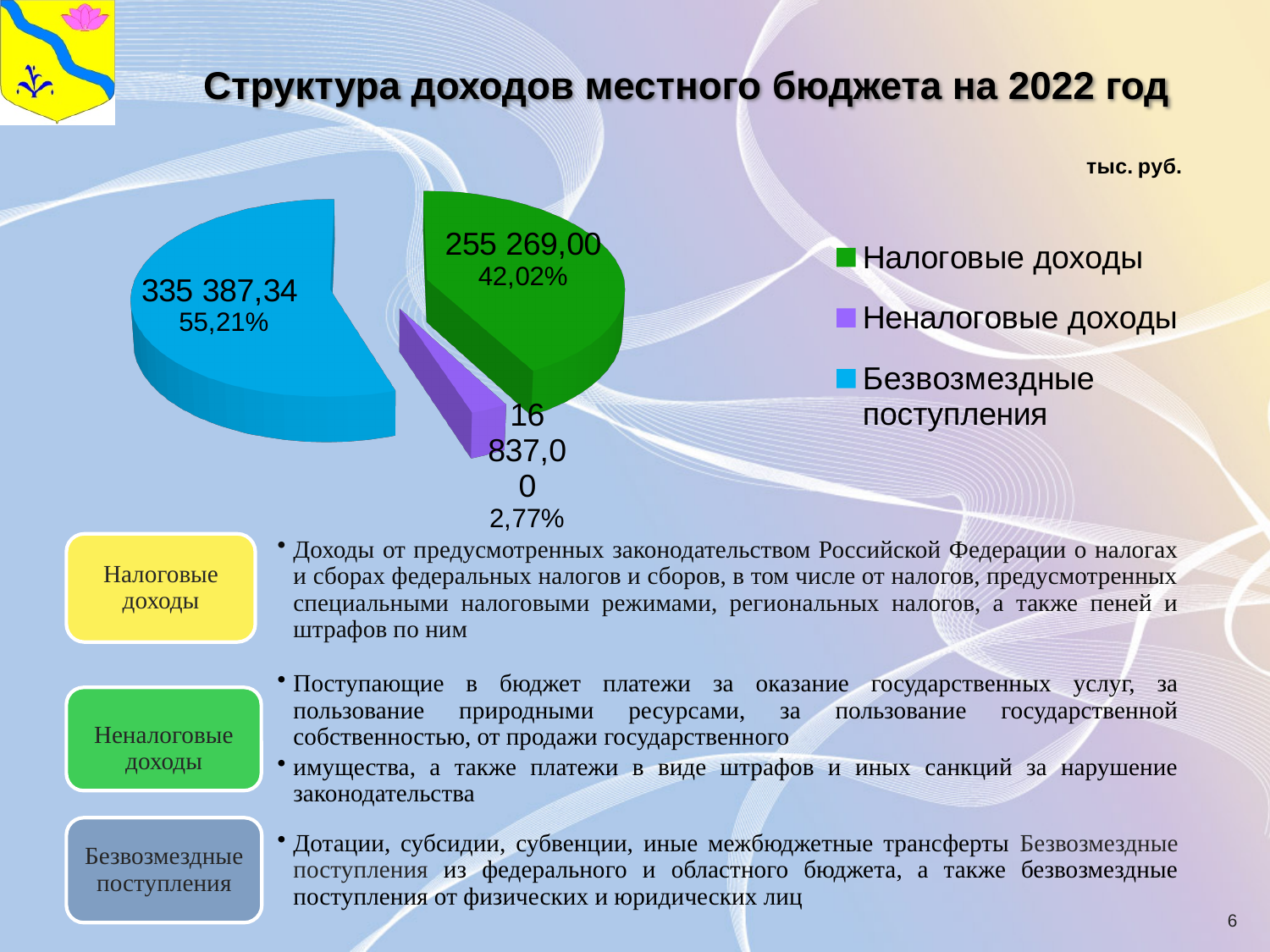
Which category has the largest value? Безвозмездные поступления Which category has the smallest value? Неналоговые доходы What is the value for Налоговые доходы? 255 269,00 What share of the pie does Безвозмездные поступления represent? 55,21% What is the value for Неналоговые доходы? 16 837,00 What is the value for Безвозмездные поступления? 335 387,34 What kind of chart is shown on the slide? pie chart What share of the pie does Налоговые доходы represent? 42,02% What share of the pie does Неналоговые доходы represent? 2,77% Which is larger, Налоговые доходы or Неналоговые доходы? Налоговые доходы What is the difference between Безвозмездные поступления and Налоговые доходы? 80 118,34 How many categories does the legend list? 3